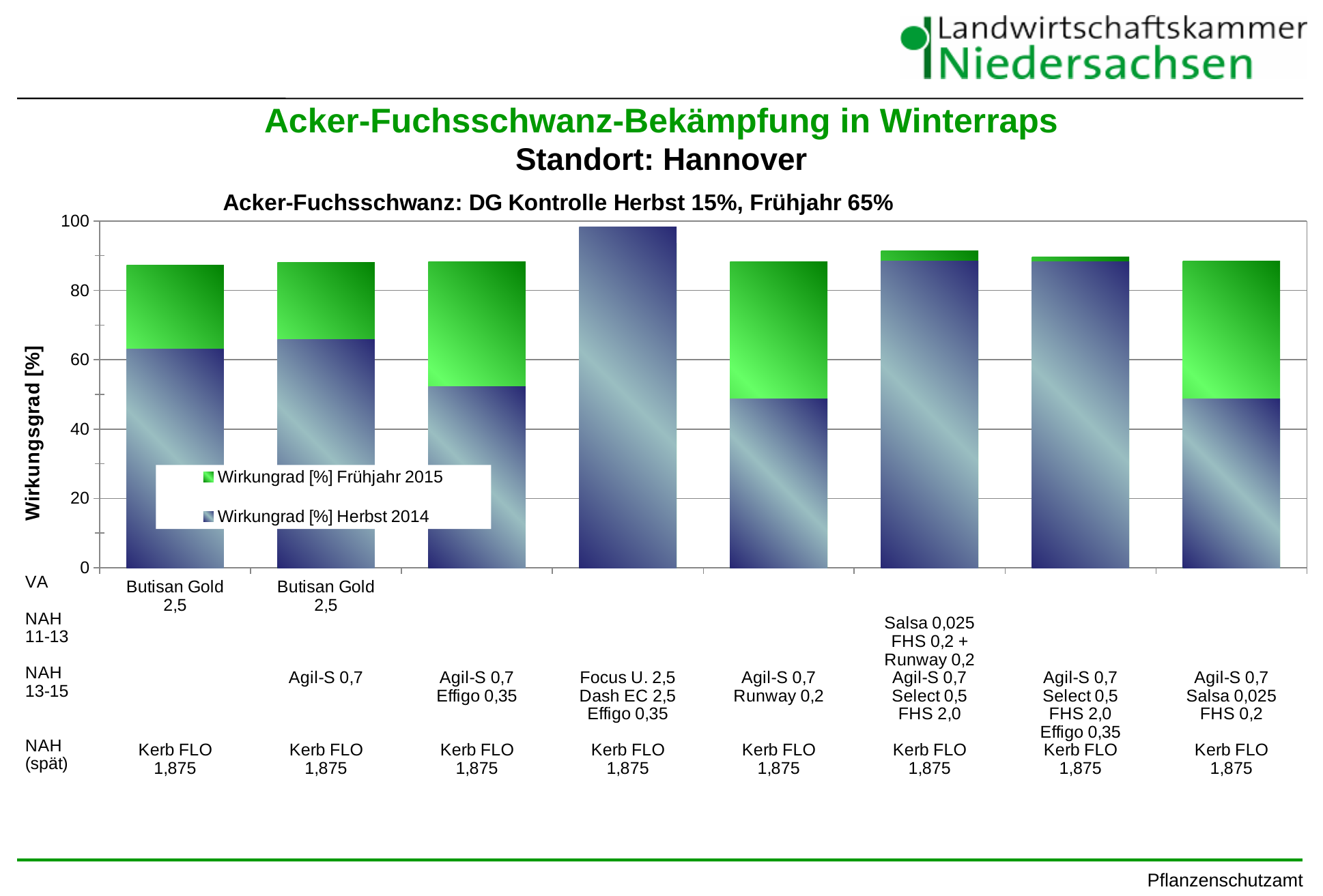
How many treatment bars (categories) are plotted in the chart? 8 Is the Wirkungsgrad [%] Frühjahr 2015 value for the Agil-S 0,7 / Salsa 0,025 / FHS 0,2 treatment greater or less than 80? greater Which treatment has the highest Wirkungsgrad [%] Herbst 2014 value? Focus U. 2,5 / Dash EC 2,5 / Effigo 0,35 (with Kerb FLO 1,875) Is the Wirkungsgrad [%] Herbst 2014 value for the Focus U. 2,5 / Dash EC 2,5 / Effigo 0,35 treatment greater or less than 90? greater How many series does the chart legend list? 2 Which has the larger Wirkungsgrad [%] Herbst 2014 value: the treatment with only Butisan Gold 2,5 (VA) and Kerb FLO 1,875, or the Agil-S 0,7 / Effigo 0,35 treatment? Butisan Gold 2,5 (VA) and Kerb FLO 1,875 Is the Wirkungsgrad [%] Herbst 2014 value for the Agil-S 0,7 / Effigo 0,35 treatment greater or less than 40? greater What is the title of the chart? Acker-Fuchsschwanz: DG Kontrolle Herbst 15%, Frühjahr 65% What is the label of the vertical axis of the chart? Wirkungsgrad [%] What kind of chart is shown on the slide? bar chart Which has the larger Wirkungsgrad [%] Herbst 2014 value: the Focus U. 2,5 / Dash EC 2,5 / Effigo 0,35 treatment or the Agil-S 0,7 / Runway 0,2 treatment? Focus U. 2,5 / Dash EC 2,5 / Effigo 0,35